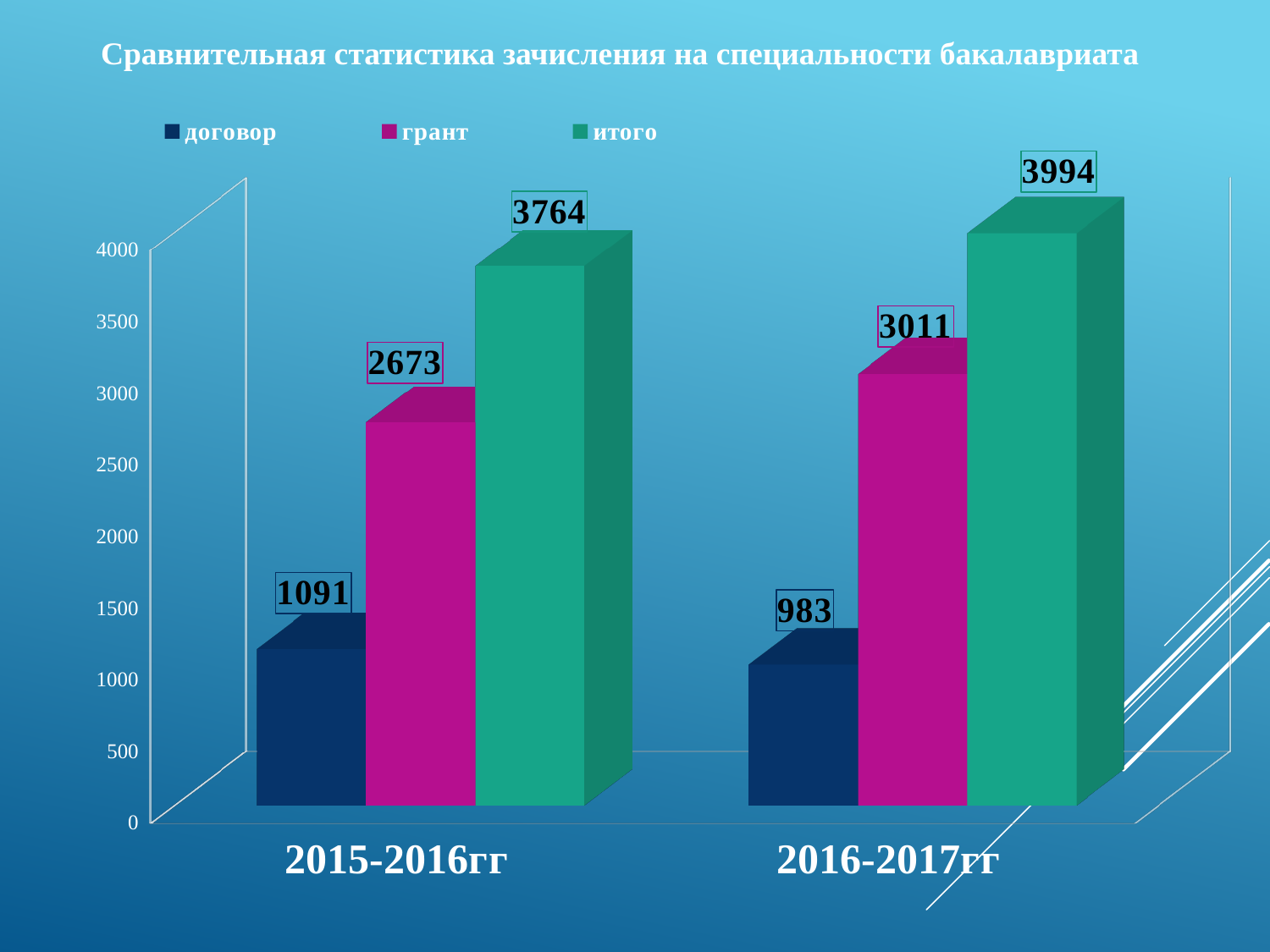
Which is larger: договор for 2015-2016гг or договор for 2016-2017гг? договор for 2015-2016гг Which series has the highest value for 2016-2017гг? итого What is the value of грант for 2016-2017гг? 3011 Which series has the lowest value for 2015-2016гг? договор How many categories are shown on the x axis? 2 What is the difference between the грант values for 2016-2017гг and 2015-2016гг? 338 What is the value of итого for 2015-2016гг? 3764 What kind of chart is shown on the slide? bar chart What is the difference between the итого values for 2016-2017гг and 2015-2016гг? 230 What is the value of договор for 2015-2016гг? 1091 What is the value of договор for 2016-2017гг? 983 How many series does the legend list? 3